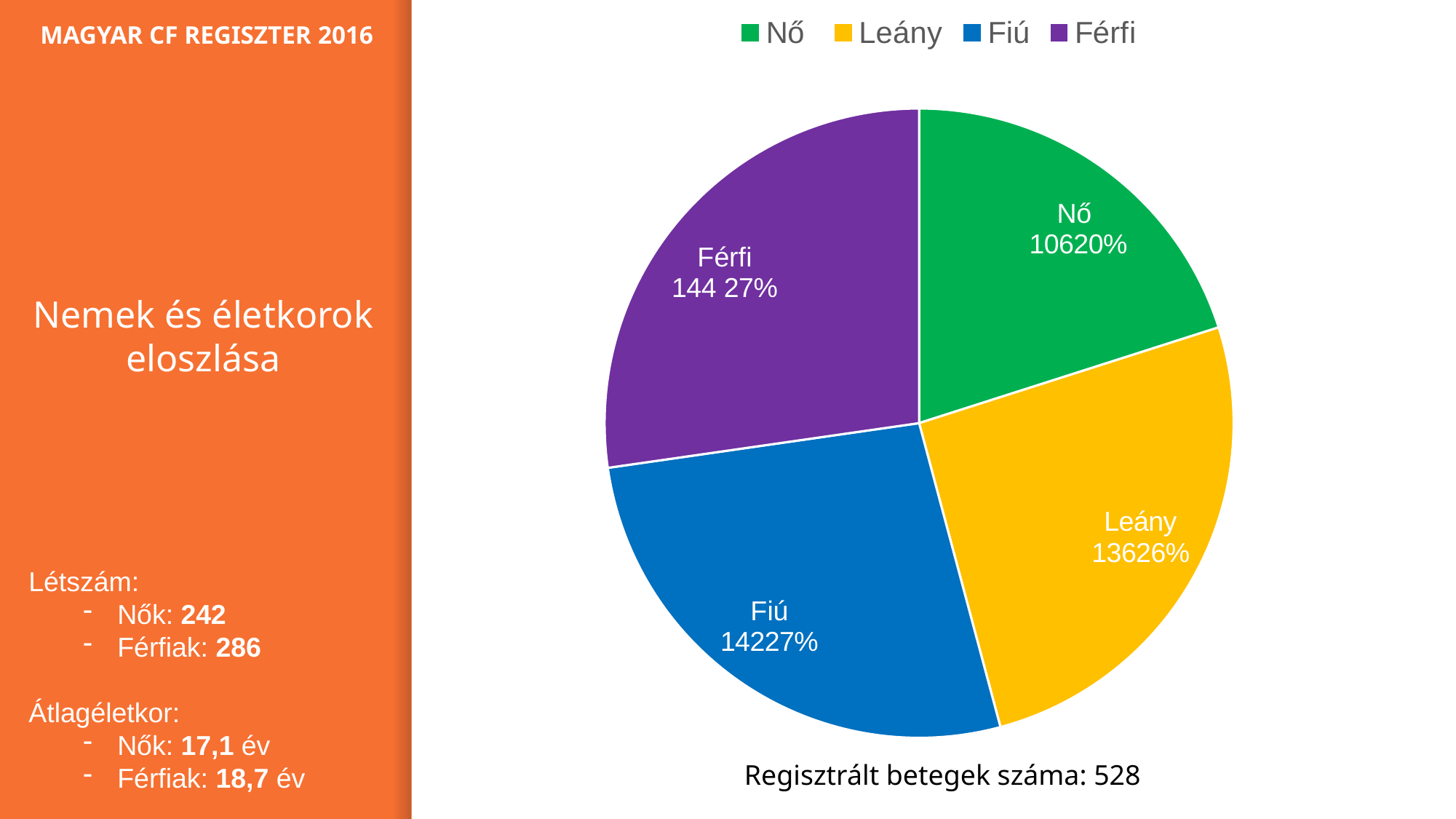
How many slices does the pie chart have? 4 What is the value shown for the Férfi slice? 144 Which colour represents the Fiú slice in the pie chart? blue How many entries does the legend of the pie chart list? 4 What percentage share is shown for the Férfi slice? 27% Which slice of the pie chart is the smallest? Nő Which legend entry is listed first in the pie chart's legend? Nő Which slice is larger, Nő or Leány? Leány What is the total number of registered patients stated below the pie chart? 528 What kind of chart is shown on the slide? pie chart